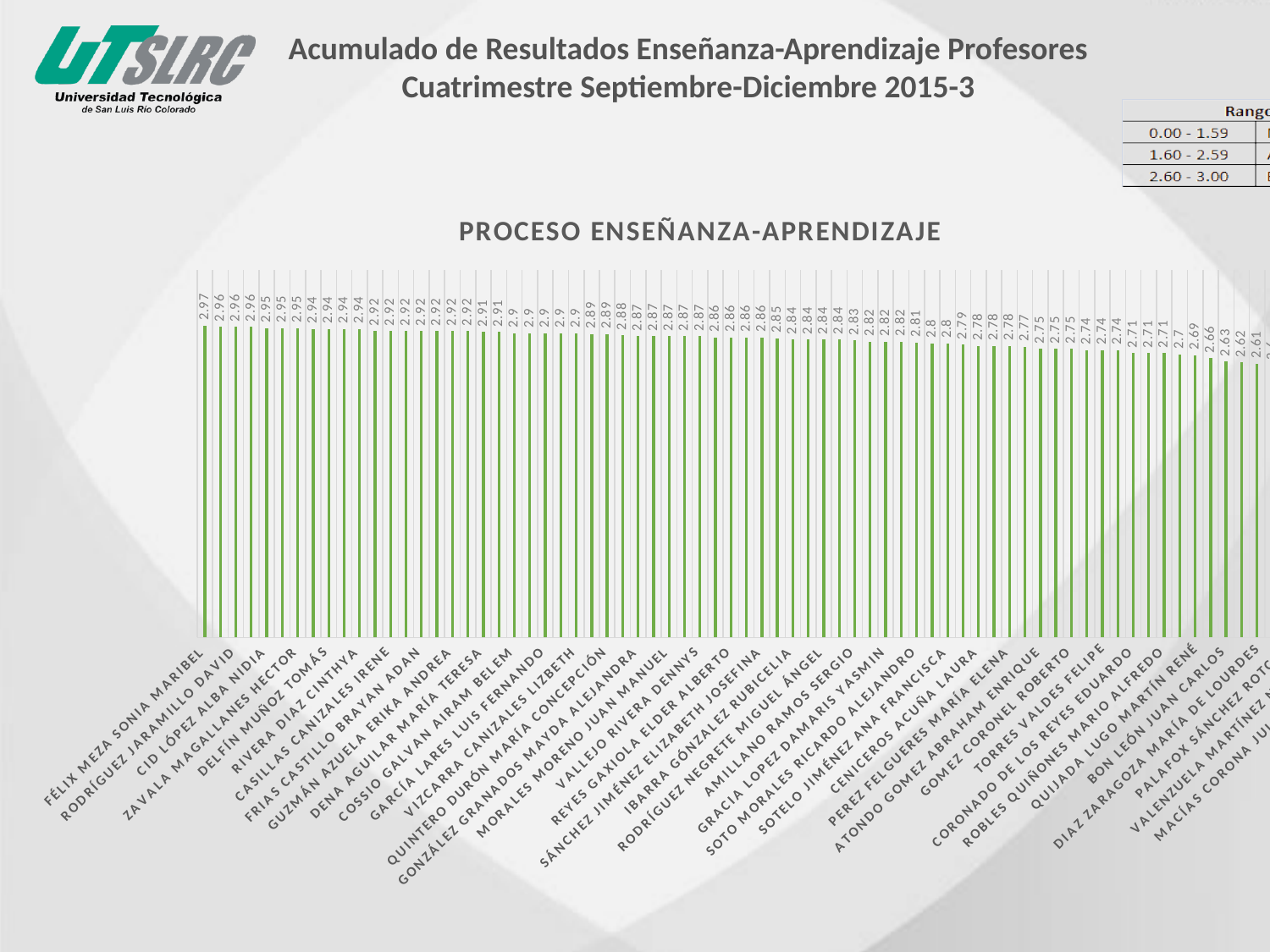
Which professor has the highest value in the chart? FÉLIX MEZA SONIA MARIBEL Is the value for FÉLIX MEZA SONIA MARIBEL larger or smaller than the value of the last fully labelled bar on the right (2.61)? larger Do the values rise or fall moving from left to right along the x axis? fall What is the value for FÉLIX MEZA SONIA MARIBEL? 2.97 What colour are the bars in the chart? green What is the difference between the highest data label (2.97) and the data label 2.61 near the right end of the chart? 0.36 What is the title of the chart? PROCESO ENSEÑANZA-APRENDIZAJE What type of chart is shown on the slide? bar chart What is the highest value shown in the chart? 2.97